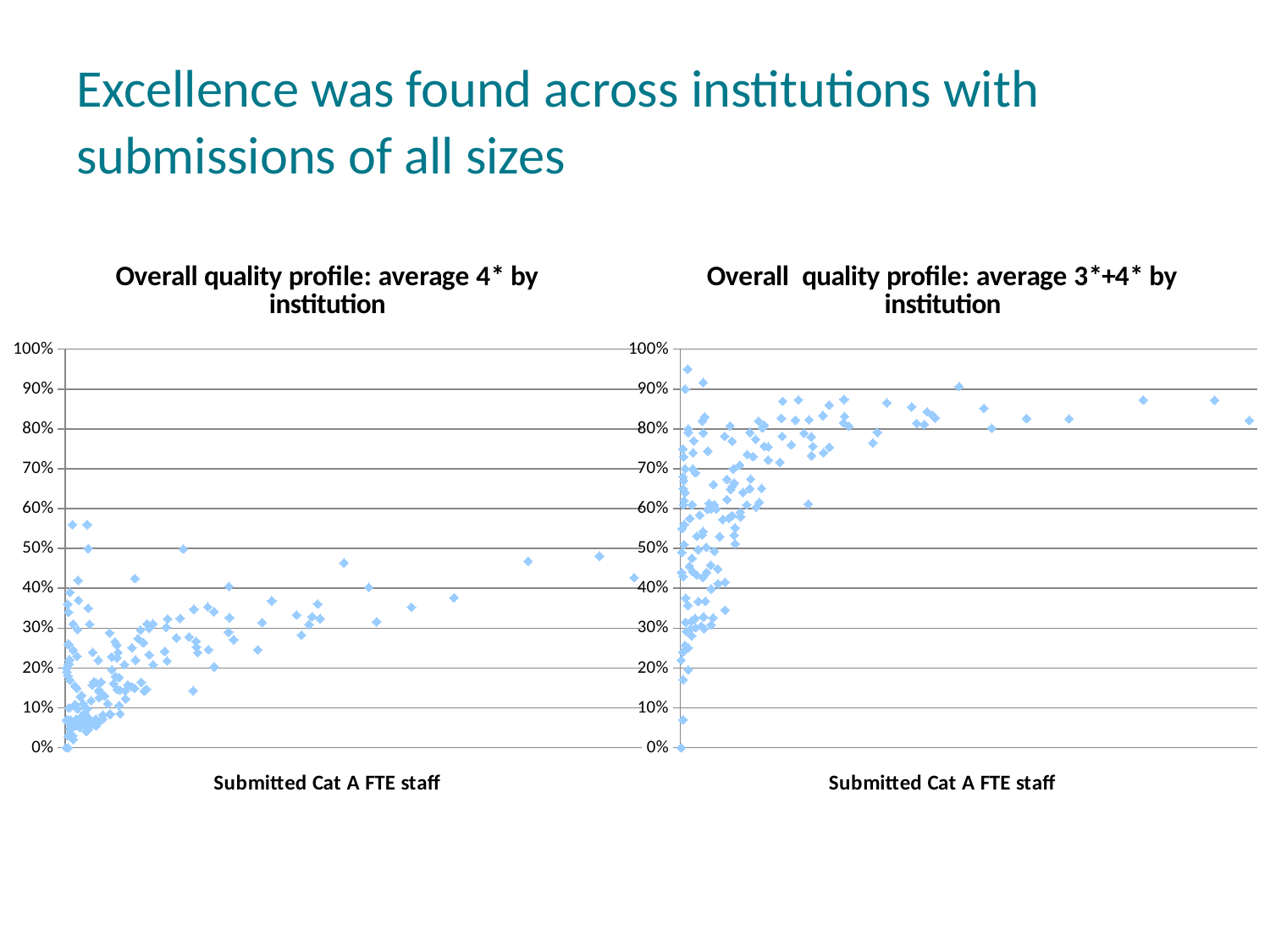
In the left chart, 'Overall quality profile: average 4* by institution', is the highest plotted point greater or less than 60%? less In the left chart, 'Overall quality profile: average 4* by institution', do the values generally rise or fall as submitted Cat A FTE staff increases along the x axis? Rise How many charts are shown on the slide? 2 What is the x-axis label of the right chart, 'Overall quality profile: average 3*+4* by institution'? Submitted Cat A FTE staff What is the title of the chart on the left of the slide? Overall quality profile: average 4* by institution What kind of chart is the right chart, 'Overall quality profile: average 3*+4* by institution'? Scatter chart In the right chart, 'Overall quality profile: average 3*+4* by institution', is the highest plotted point greater or less than 90%? greater In the left chart, 'Overall quality profile: average 4* by institution', is the highest plotted point greater or less than 50%? greater What kind of chart is the left chart, 'Overall quality profile: average 4* by institution'? Scatter chart In the right chart, 'Overall quality profile: average 3*+4* by institution', do the values generally rise or fall as submitted Cat A FTE staff increases along the x axis? Rise